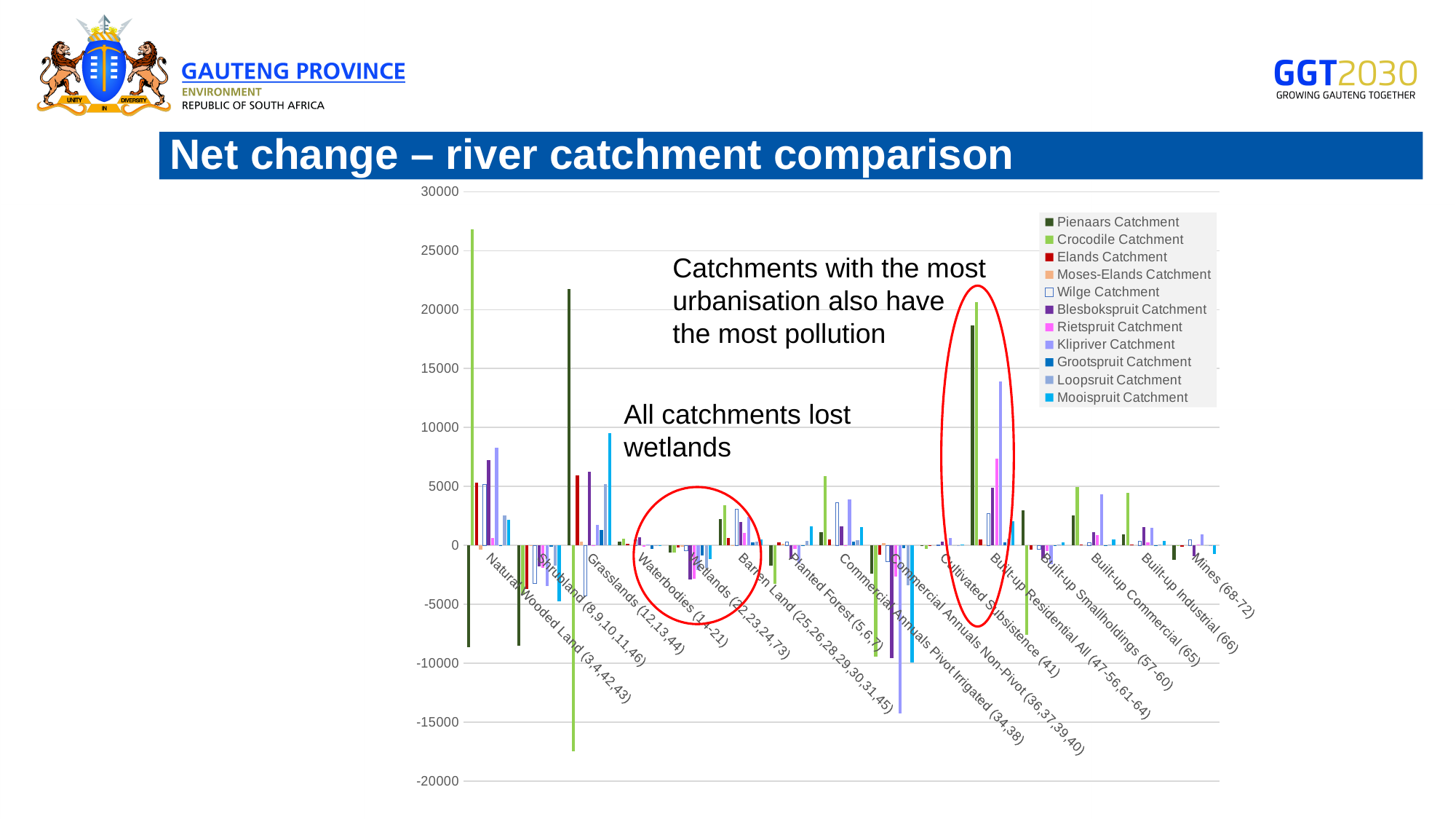
What is the title of the chart slide? Net change – river catchment comparison Is the Pienaars Catchment value for Grasslands (12,13,44) greater or less than 20000? greater What type of chart is shown on the slide? Bar chart According to the annotation on the chart, what did all catchments lose? Wetlands How many catchments are listed in the chart legend? 11 For Built-up Residential All (47-56,61-64), which is larger: the Crocodile Catchment value or the Klipriver Catchment value? Crocodile Catchment Which catchment has the highest value for Natural Wooded Land (3,4,42,43)? Crocodile Catchment Is the Crocodile Catchment value for Natural Wooded Land (3,4,42,43) greater or less than 25000? greater Is the Crocodile Catchment value for Grasslands (12,13,44) greater or less than -15000? less How many land-cover categories are shown along the x axis of the chart? 15 Which catchment has the lowest value for Grasslands (12,13,44)? Crocodile Catchment